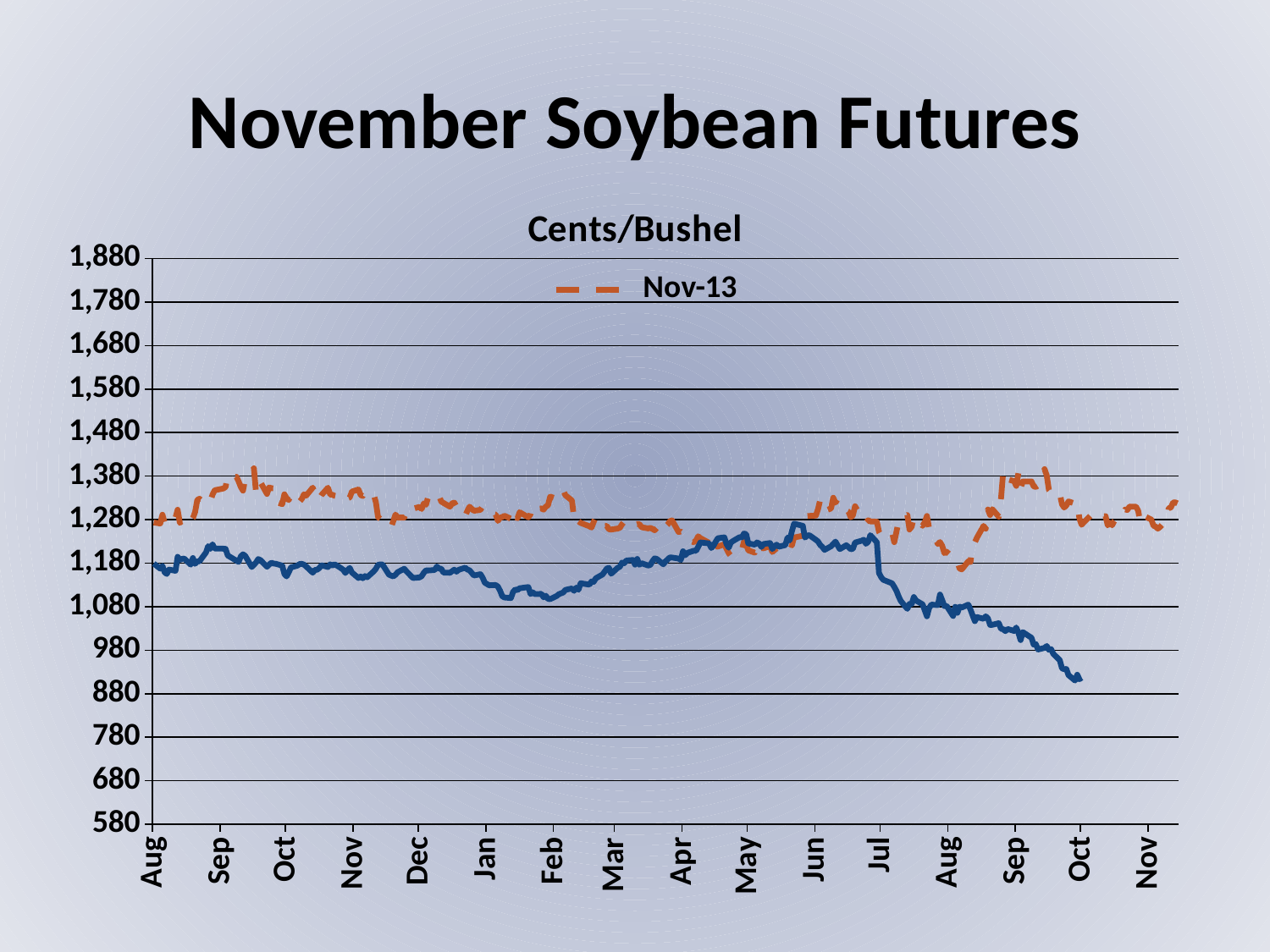
Is the value of the solid blue line at Feb greater or less than 1,180? less Is the value of the solid blue line at the second Oct label greater or less than 980? less Does the solid blue line rise or fall between Jul and the second Oct label? fall What kind of chart is shown on the slide? line chart Is the value of the Nov-13 series at the second Aug label greater or less than 1,280? less At Jan, which line is higher, the Nov-13 dashed line or the solid blue line? Nov-13 How many series does the legend list? 1 What is the title of the slide? November Soybean Futures How many month labels are shown along the x axis? 16 What is the chart's title above the plot area? Cents/Bushel